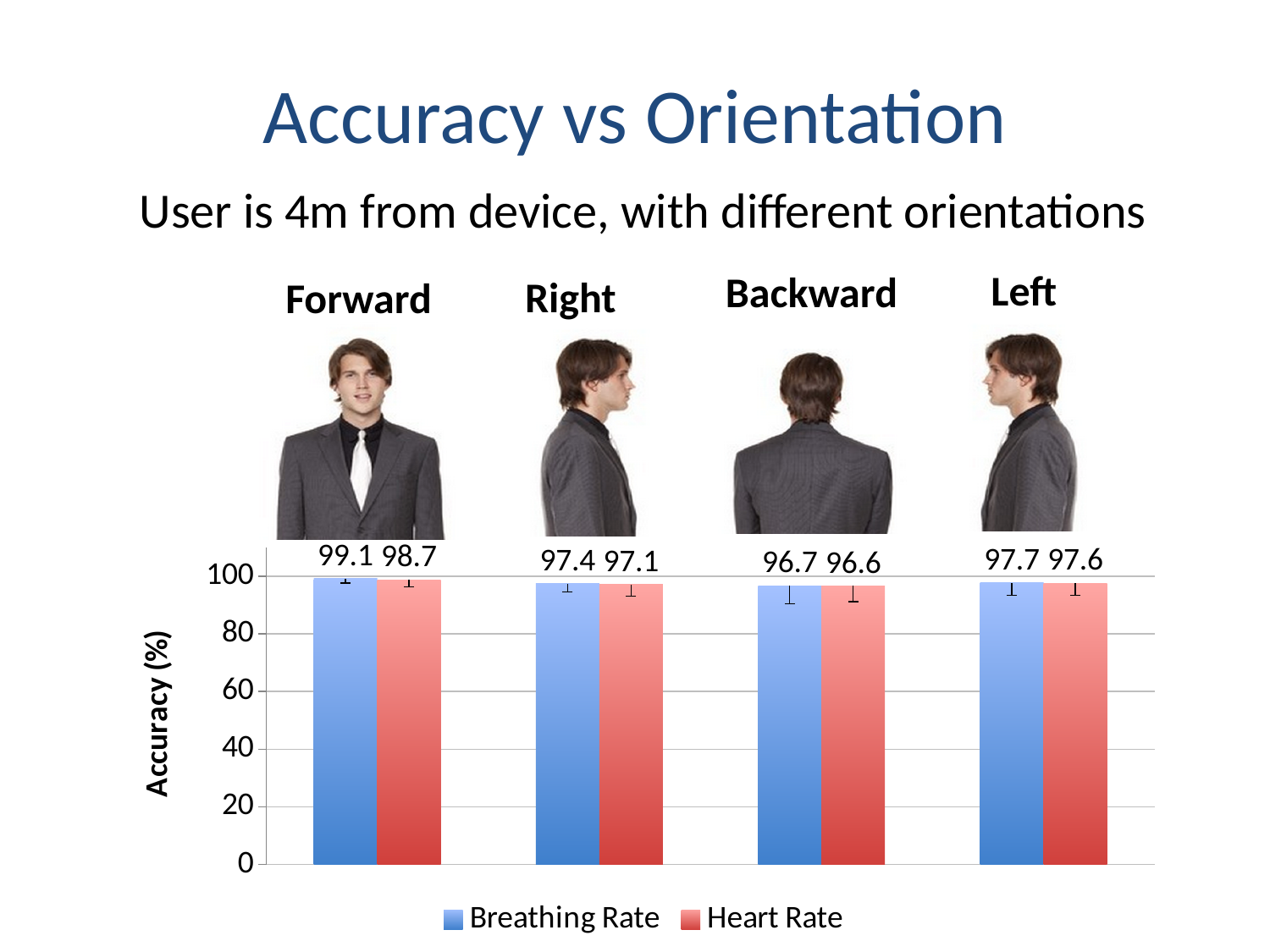
How many orientations are shown on the x axis of the chart? 4 What is the Breathing Rate accuracy for the Forward orientation? 99.1 What is the Heart Rate accuracy for the Left orientation? 97.6 Which is larger: the Heart Rate accuracy for Forward or for Left? Forward Which orientation has the highest Breathing Rate accuracy? Forward What is the Heart Rate accuracy for the Backward orientation? 96.6 Which orientation has the lowest Heart Rate accuracy? Backward What is the Breathing Rate accuracy for the Right orientation? 97.4 Is the Breathing Rate accuracy for Backward greater or less than 80? greater How many series does the legend list? 2 What kind of chart is shown on the slide? bar chart What is the difference between the Breathing Rate accuracy for Forward and for Backward? 2.4